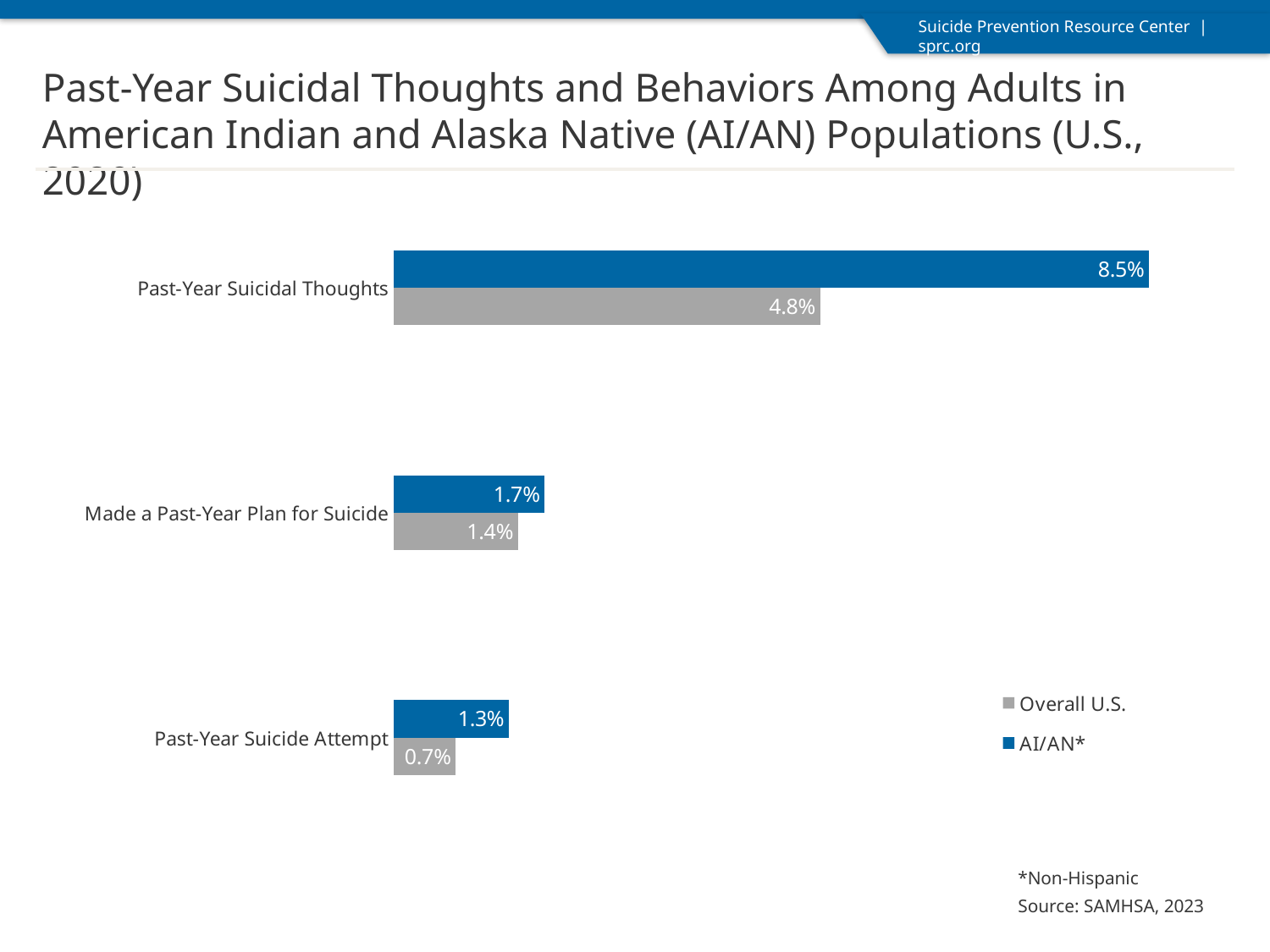
Which category has the lowest Overall U.S. value? Past-Year Suicide Attempt Which is larger for Made a Past-Year Plan for Suicide: the AI/AN* value or the Overall U.S. value? AI/AN* How many series does the legend list? 2 Which category has the highest AI/AN* value? Past-Year Suicidal Thoughts What is the AI/AN* value for Made a Past-Year Plan for Suicide? 1.7% What is the Overall U.S. value for Past-Year Suicidal Thoughts? 4.8% What is the AI/AN* value for Past-Year Suicidal Thoughts? 8.5% How many categories are shown in the chart? 3 What is the difference between the AI/AN* and Overall U.S. values for Past-Year Suicidal Thoughts? 3.7% What is the Overall U.S. value for Past-Year Suicide Attempt? 0.7% What kind of chart is shown on the slide? Bar chart What is the difference between the AI/AN* and Overall U.S. values for Past-Year Suicide Attempt? 0.6%